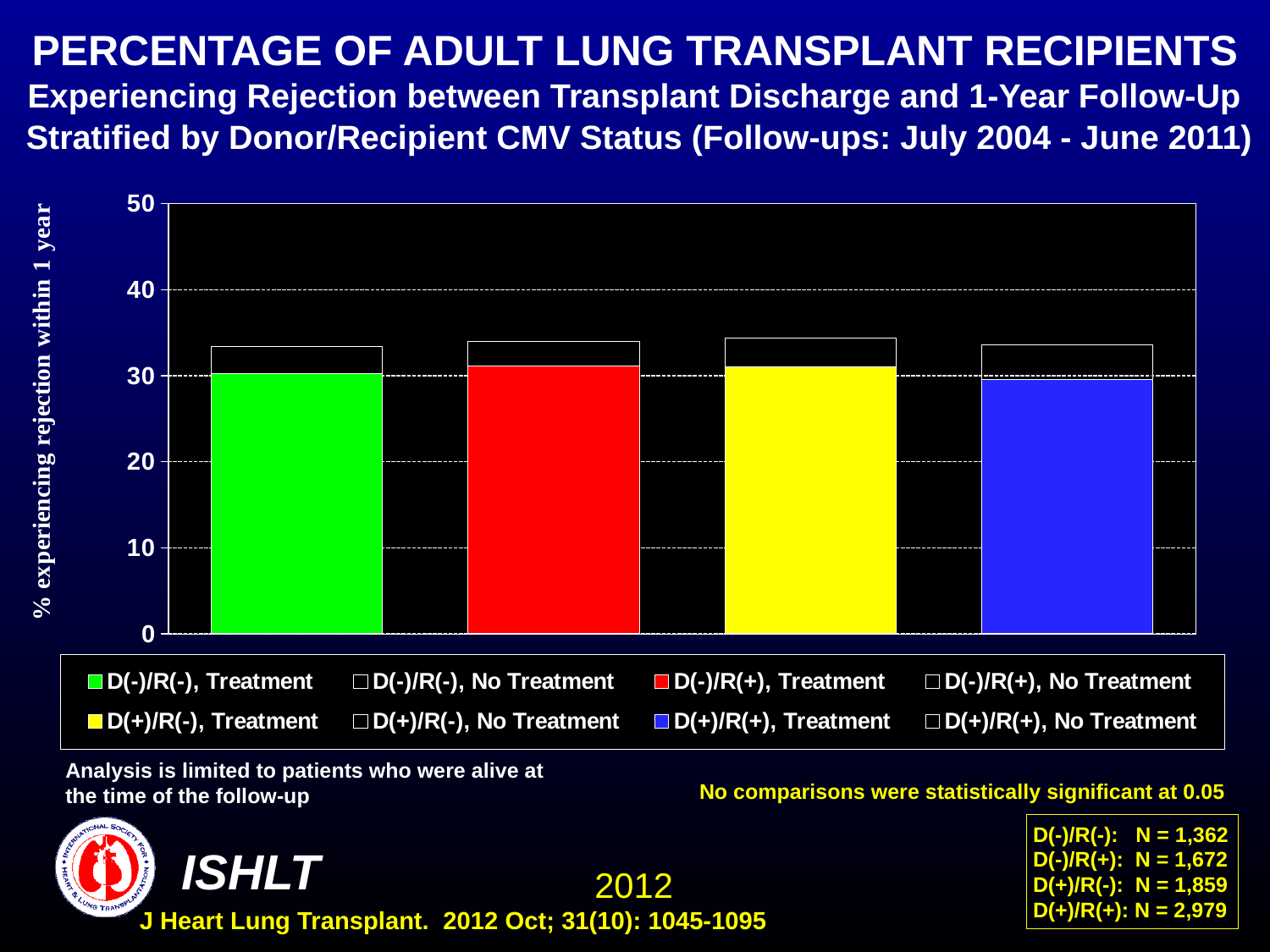
How many series does the legend list? 8 Is the total height of the D(-)/R(-) stacked bar greater or less than 30? greater Is the value for D(+)/R(-), Treatment greater or less than 30? greater How many stacked bars (donor/recipient CMV status groups) are plotted? 4 Is the total height of the D(+)/R(+) stacked bar greater or less than 40? less What is the label on the y axis? % experiencing rejection within 1 year What colour represents D(-)/R(+), Treatment in the legend? red What kind of chart is shown on the slide? bar chart